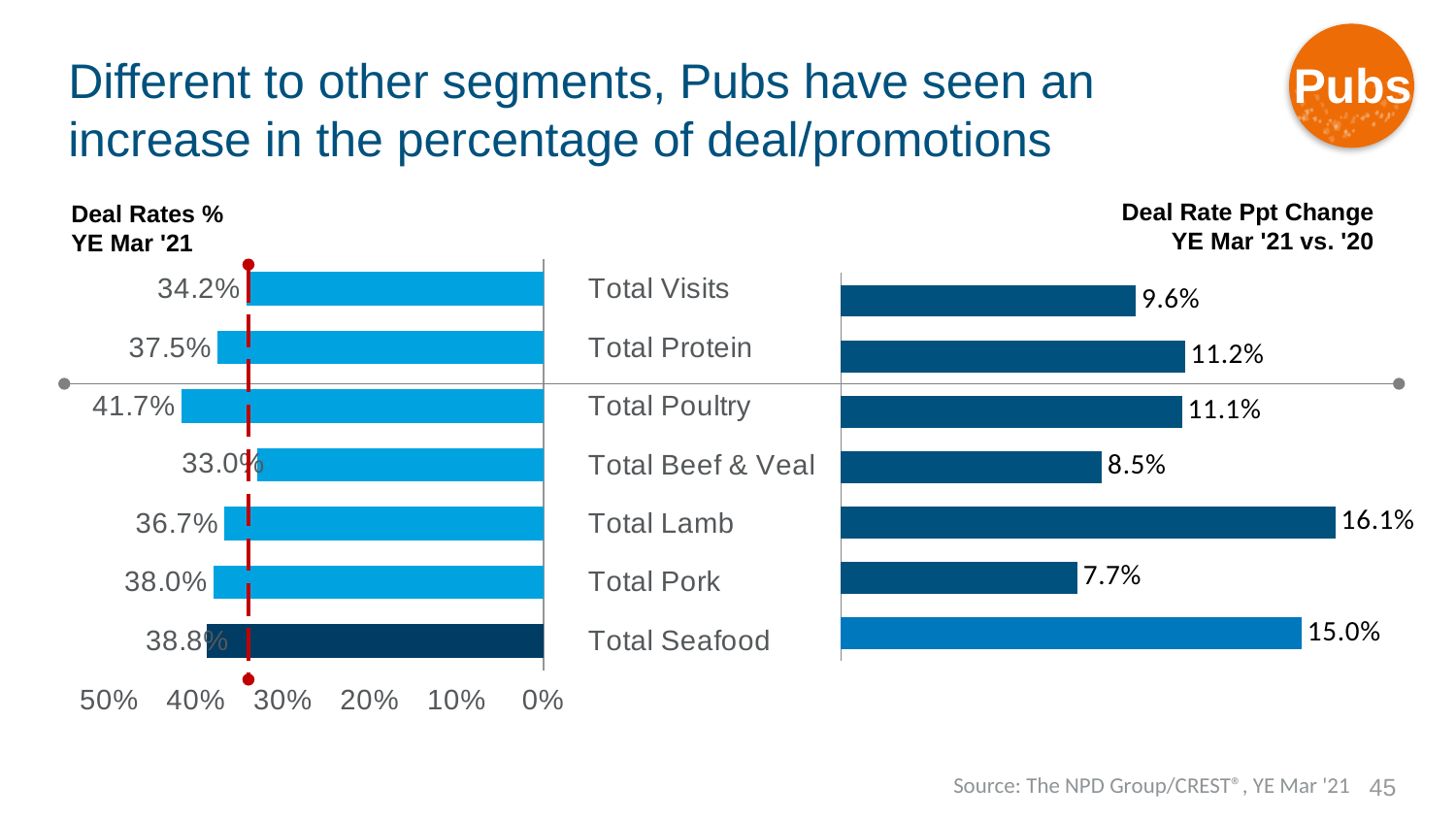
In the Deal Rates % YE Mar '21 chart, what is the value for Total Poultry? 41.7% In the Deal Rate Ppt Change YE Mar '21 vs. '20 chart, which category has the lowest value? Total Pork In the Deal Rates % YE Mar '21 chart, is the value for Total Poultry greater or less than 40%? greater In the Deal Rate Ppt Change YE Mar '21 vs. '20 chart, which category has the highest value? Total Lamb In the Deal Rates % YE Mar '21 chart, what is the difference between Total Seafood and Total Visits? 4.6% What kind of chart is the Deal Rates % YE Mar '21 chart? Bar chart In the Deal Rate Ppt Change YE Mar '21 vs. '20 chart, what is the difference between Total Lamb and Total Pork? 8.4% In the Deal Rate Ppt Change YE Mar '21 vs. '20 chart, which is larger, Total Protein or Total Poultry? Total Protein In the Deal Rates % YE Mar '21 chart, which category has the lowest value? Total Beef & Veal In the Deal Rates % YE Mar '21 chart, which category has the highest value? Total Poultry In the Deal Rate Ppt Change YE Mar '21 vs. '20 chart, what is the value for Total Lamb? 16.1% How many categories are shown in the Deal Rate Ppt Change YE Mar '21 vs. '20 chart? 7